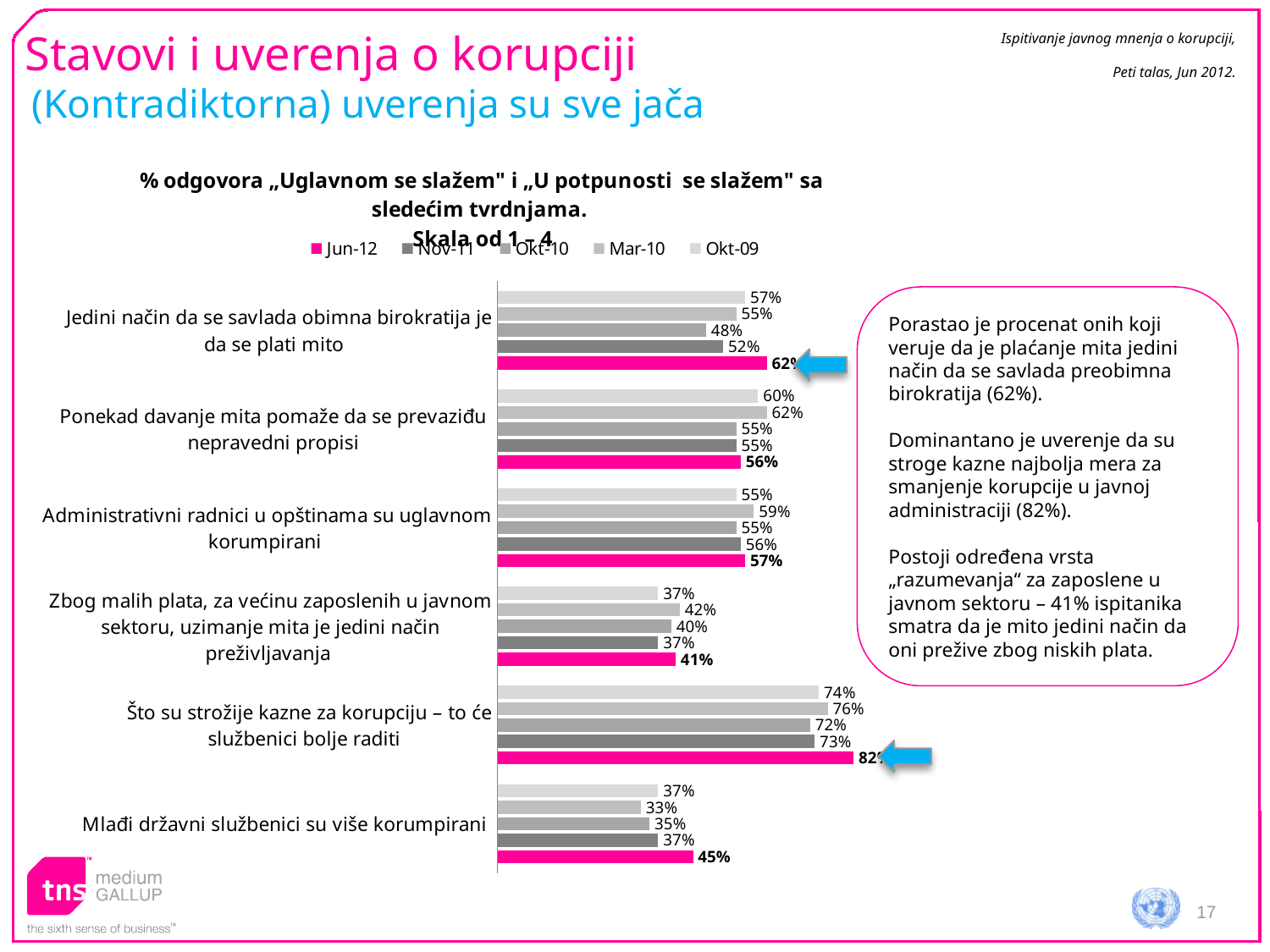
What colour are the Jun-12 bars in the chart? Magenta (pink) Which statement has the highest Jun-12 value? Što su strožije kazne za korupciju – to će službenici bolje raditi How many series does the legend list? 5 Which has the larger Jun-12 value: "Jedini način da se savlada obimna birokratija je da se plati mito" or "Ponekad davanje mita pomaže da se prevaziđu nepravedni propisi"? Jedini način da se savlada obimna birokratija je da se plati mito What is the difference between the Jun-12 value for "Što su strožije kazne za korupciju" and the Jun-12 value for "Mlađi državni službenici su više korumpirani"? 37 percentage points What is the Jun-12 value for "Mlađi državni službenici su više korumpirani"? 45% What is the Jun-12 value for the statement "Što su strožije kazne za korupciju – to će službenici bolje raditi"? 82% What kind of chart is shown on the slide? Bar chart How many statements (categories) are shown in the chart? 6 What is the Jun-12 value for "Zbog malih plata, za većinu zaposlenih u javnom sektoru, uzimanje mita je jedini način preživljavanja"? 41% What is the Nov-11 value for "Jedini način da se savlada obimna birokratija je da se plati mito"? 52% Which statement has the lowest Jun-12 value? Zbog malih plata, za većinu zaposlenih u javnom sektoru, uzimanje mita je jedini način preživljavanja